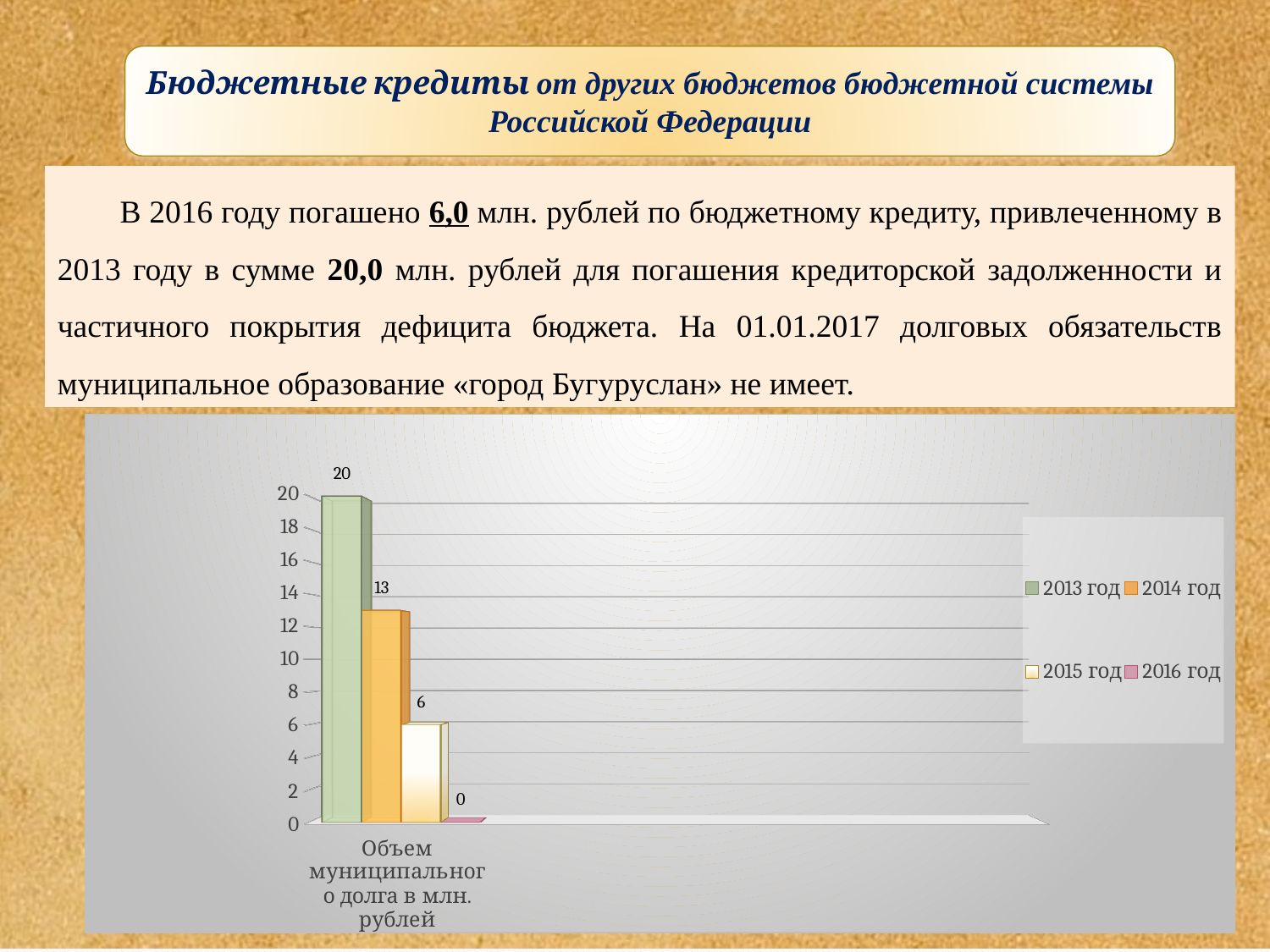
What is the value for 2016 год in the chart? 0 What is the value for 2015 год in the chart? 6 Which series has the highest value in the chart? 2013 год Which series has the lowest value in the chart? 2016 год What kind of chart is shown on the slide? bar chart Do the values fall or rise from 2013 год to 2016 год? fall What is the difference between the values for 2014 год and 2015 год? 7 How many series does the legend list? 4 Which is larger, the value for 2014 год or the value for 2015 год? 2014 год What is the difference between the values for 2013 год and 2014 год? 7 What is the value for 2014 год in the chart? 13 What is the value for 2013 год in the chart? 20